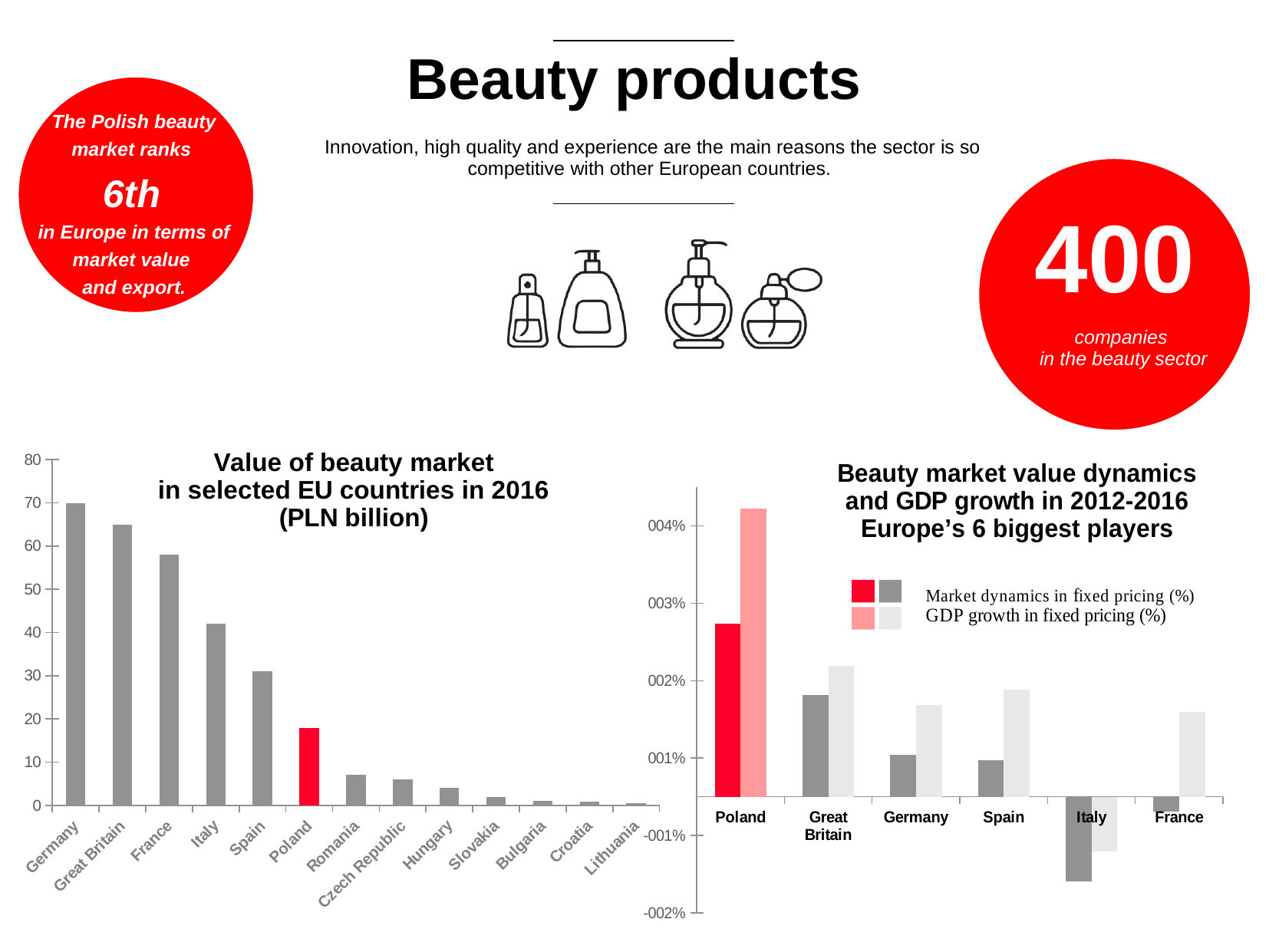
In the 'Value of beauty market in selected EU countries in 2016' chart, which country's bar is coloured red? Poland How many series does the legend list in the 'Beauty market value dynamics and GDP growth in 2012-2016' chart? 2 In the 'Beauty market value dynamics and GDP growth in 2012-2016' chart, which country has the lowest market dynamics in fixed pricing? Italy In the 'Beauty market value dynamics and GDP growth in 2012-2016' chart, which country has the highest market dynamics in fixed pricing? Poland What type of chart is the 'Value of beauty market in selected EU countries in 2016' chart? bar chart In the 'Value of beauty market in selected EU countries in 2016' chart, which country has the highest value? Germany In the 'Value of beauty market in selected EU countries in 2016' chart, which is larger, the value for France or the value for Italy? France In the 'Value of beauty market in selected EU countries in 2016' chart, is the value for Poland greater or less than 20? less In the 'Value of beauty market in selected EU countries in 2016' chart, do the values rise or fall from left to right along the x axis? fall In the 'Value of beauty market in selected EU countries in 2016' chart, is the value for France greater or less than 50? greater How many countries are shown in the 'Value of beauty market in selected EU countries in 2016' chart? 13